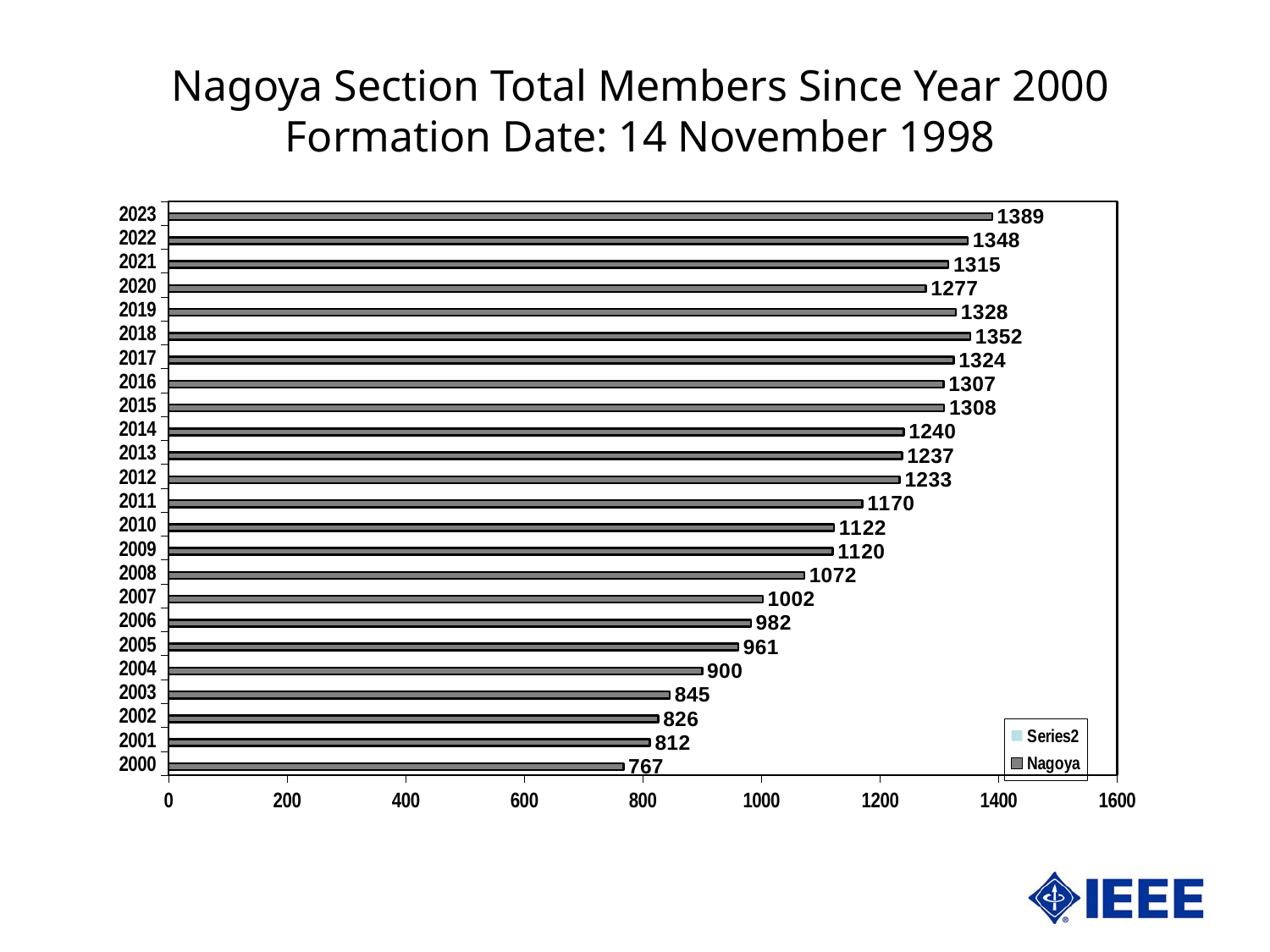
What is the value for 2012? 1233 What is the value for 2023? 1389 Is the value for 2007 greater or less than 1000? greater What is the difference between the values for 2018 and 2017? 28 How many series does the legend list? 2 What is the value for 2000? 767 What kind of chart is shown on the slide? bar chart Which year has the lowest value? 2000 Which year has the highest value? 2023 Which is larger, the value for 2019 or the value for 2020? 2019 What is the difference between the values for 2023 and 2000? 622 How many years are shown on the chart? 24